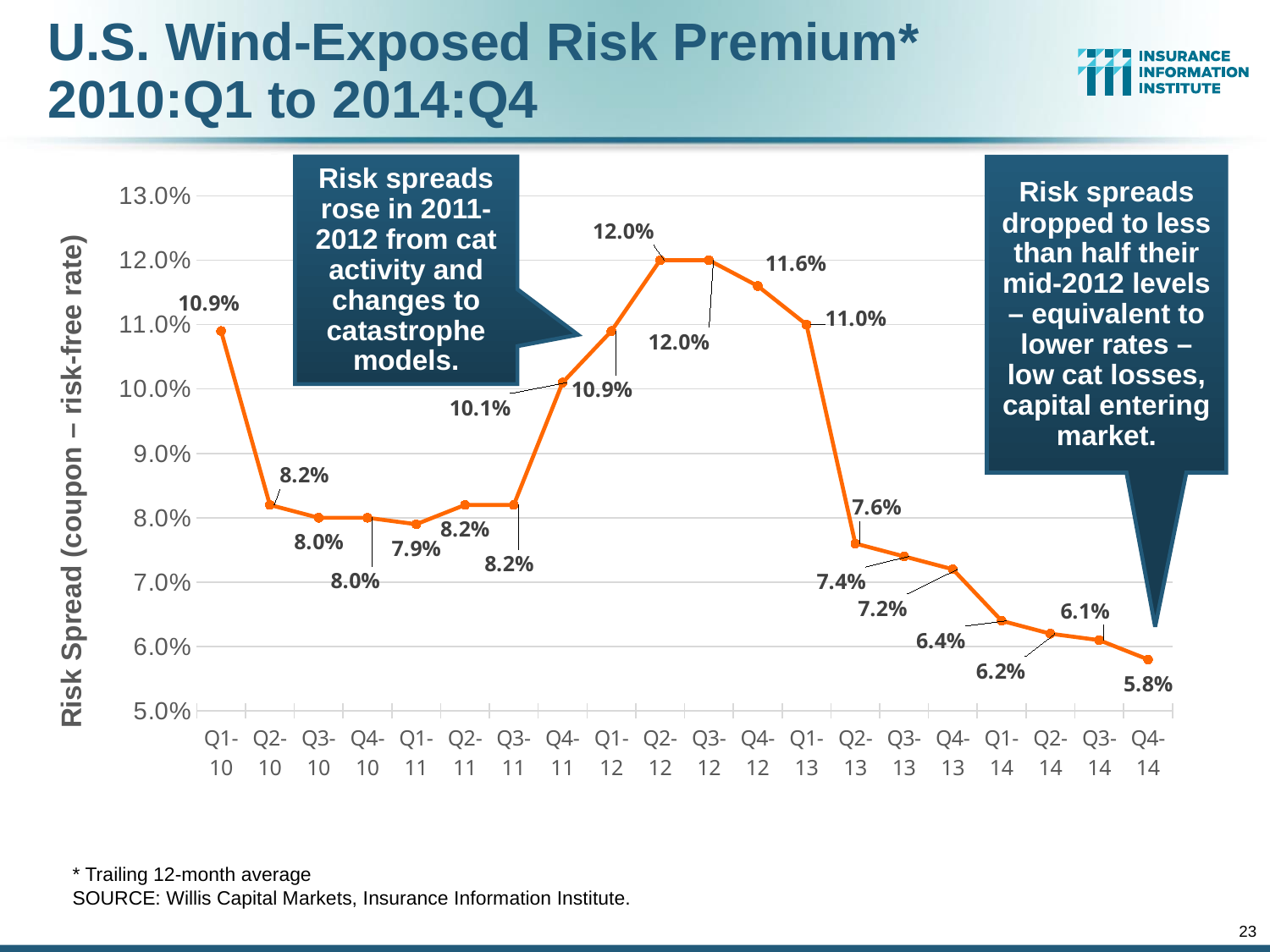
What is the difference between the risk spread in Q1-13 and Q2-13? 3.4 percentage points What is the risk spread for Q2-13? 7.6% Which is larger, the risk spread in Q1-10 or in Q4-11? Q1-10 How many quarters are plotted on the x axis? 20 What is the risk spread for Q4-12? 11.6% What is the highest risk spread value shown on the chart? 12.0% Is the risk spread for Q3-12 greater or less than 11.0%? greater Do the risk spread values rise or fall from Q1-13 to Q4-14? Fall What is the risk spread for Q1-10? 10.9% Which quarter has the lowest risk spread? Q4-14 What kind of chart is shown on the slide? Line chart What is the risk spread for Q4-14? 5.8%